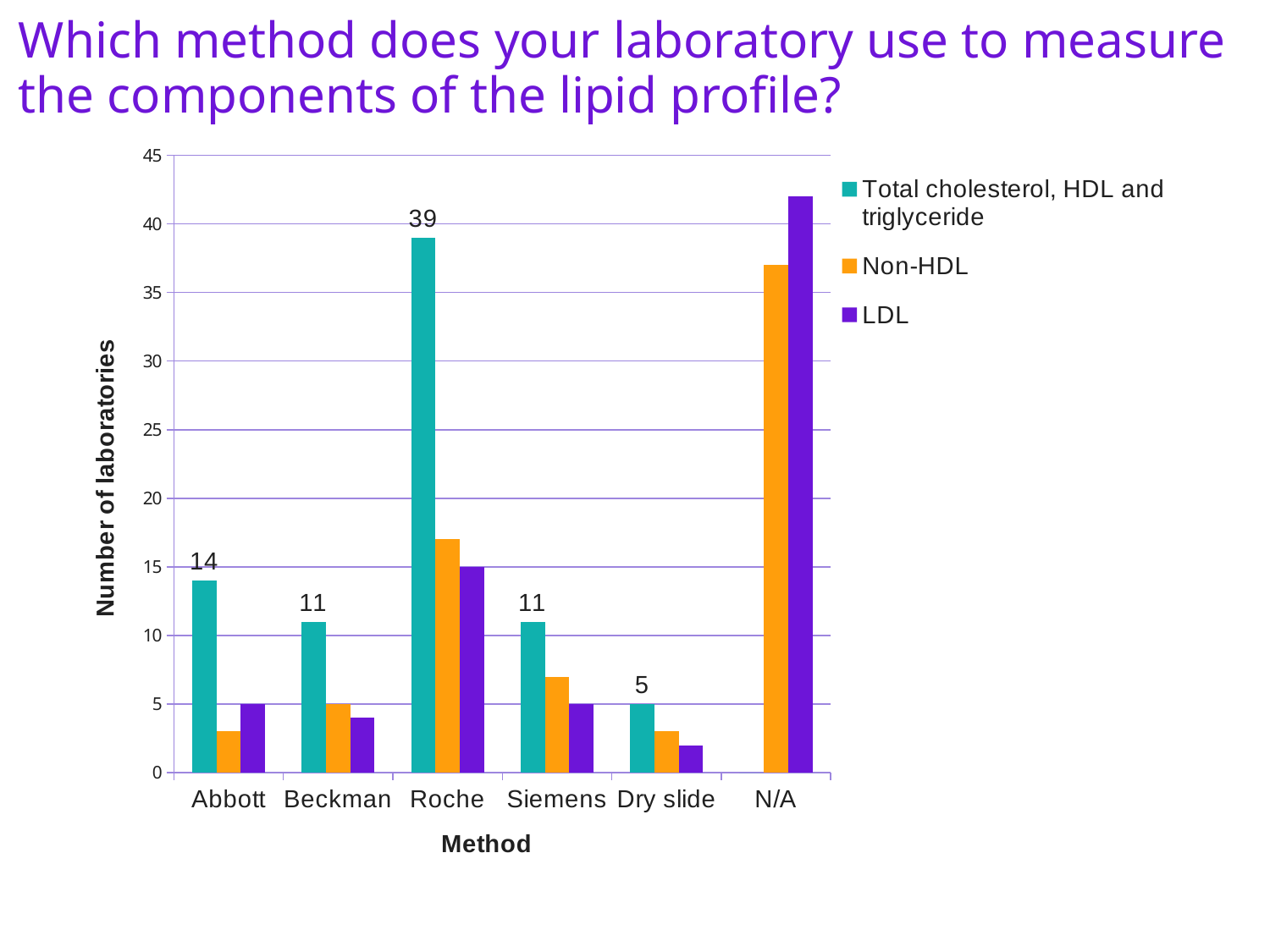
What is the value for Roche in the Total cholesterol, HDL and triglyceride series? 39 What is the difference between the Total cholesterol, HDL and triglyceride values for Roche and Abbott? 25 Which method has the highest value in the Total cholesterol, HDL and triglyceride series? Roche What kind of chart is shown on the slide? Bar chart Is the Non-HDL value for Roche greater or less than 20? less Is the LDL value for N/A greater or less than 40? greater Among the methods that have a Total cholesterol, HDL and triglyceride bar, which has the lowest value? Dry slide How many methods are shown on the x axis? 6 How many series does the legend list? 3 In the Total cholesterol, HDL and triglyceride series, which is larger: Abbott or Beckman? Abbott What is the value for Dry slide in the Total cholesterol, HDL and triglyceride series? 5 What is the value for Abbott in the Total cholesterol, HDL and triglyceride series? 14